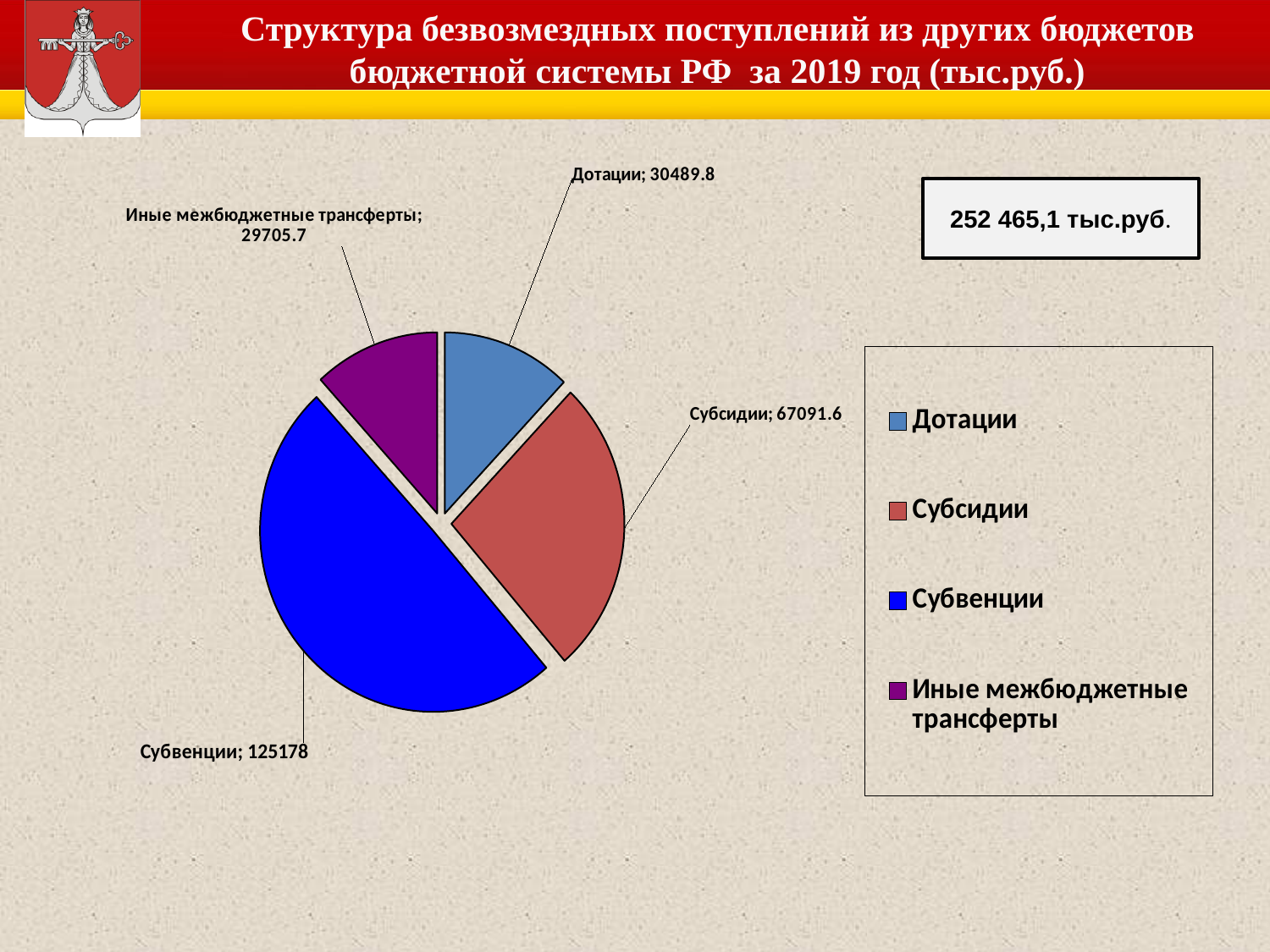
What type of chart is shown on the slide? pie chart Which category has the largest slice in the pie chart? Субвенции What is the value for Иные межбюджетные трансферты in the pie chart? 29705.7 What total amount is shown in the box to the right of the pie chart? 252 465,1 тыс.руб. What is the difference between the values for Субвенции and Субсидии? 58086.4 Which category has the smallest slice in the pie chart? Иные межбюджетные трансферты How many categories are shown in the pie chart? 4 What is the difference between the values for Субсидии and Дотации? 36601.8 What is the value for Субвенции in the pie chart? 125178 Which is larger, the value for Субсидии or the value for Дотации? Субсидии What is the value for Субсидии in the pie chart? 67091.6 What is the value for Дотации in the pie chart? 30489.8